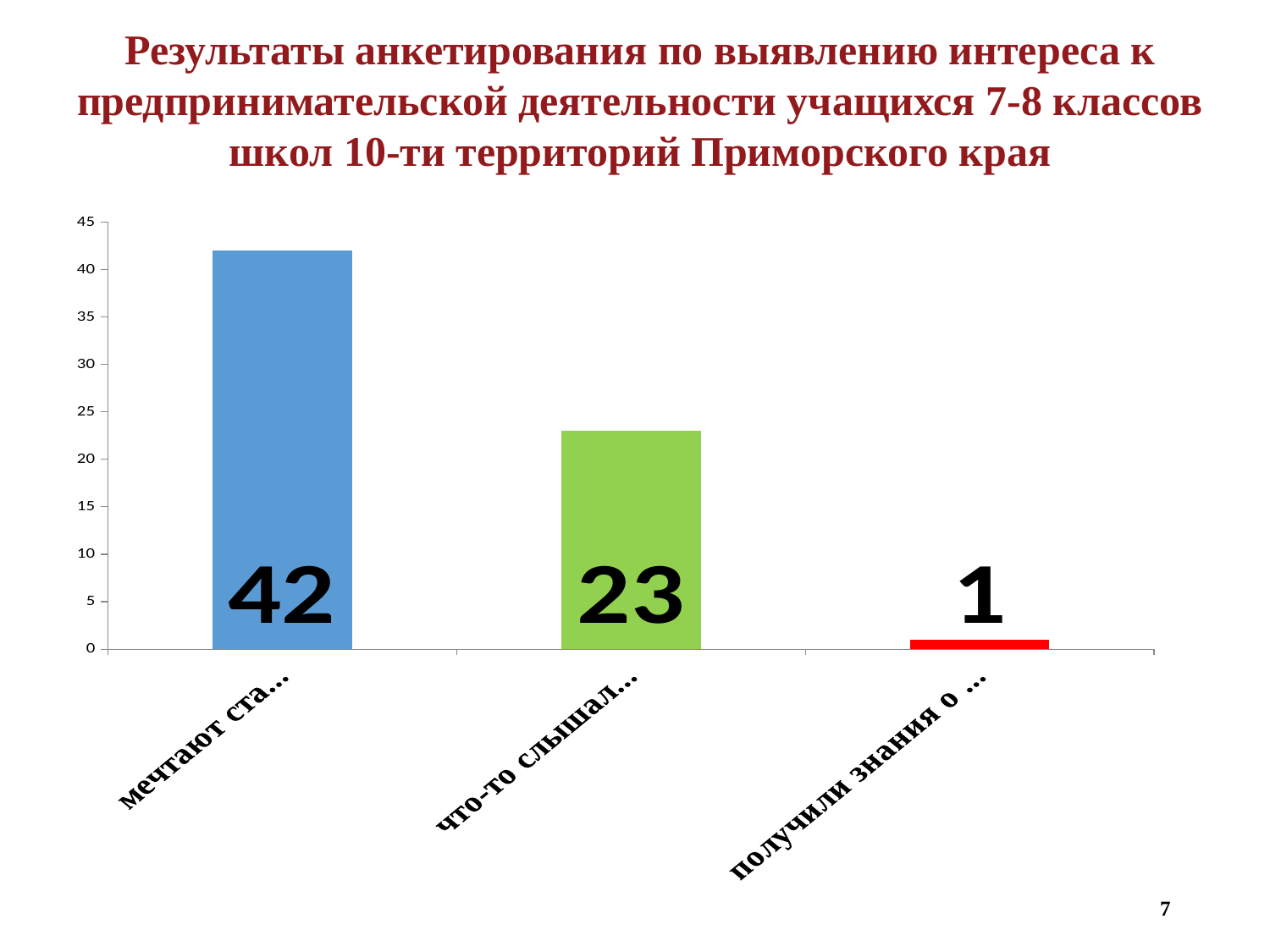
Which category has the lowest value? получили знания о ... (the third, red bar) What is the difference between the values of the first bar (42) and the second bar (23)? 19 What colour is the bar with the value 23? green Which category has the highest value? мечтают ста... (the first, blue bar) What is the difference between the values of the second bar (23) and the third bar (1)? 22 What is the value of the second (green) bar, labelled "что-то слышал..."? 23 What is the value of the third (red) bar, labelled "получили знания о ..."? 1 What kind of chart is shown on the slide? bar chart How many categories (bars) are shown in the chart? 3 What is the value of the first (blue) bar, labelled "мечтают ста..."? 42 Is the value for "что-то слышал..." greater or less than 25? less Which is larger: the value for "мечтают ста..." or the value for "что-то слышал..."? мечтают ста...